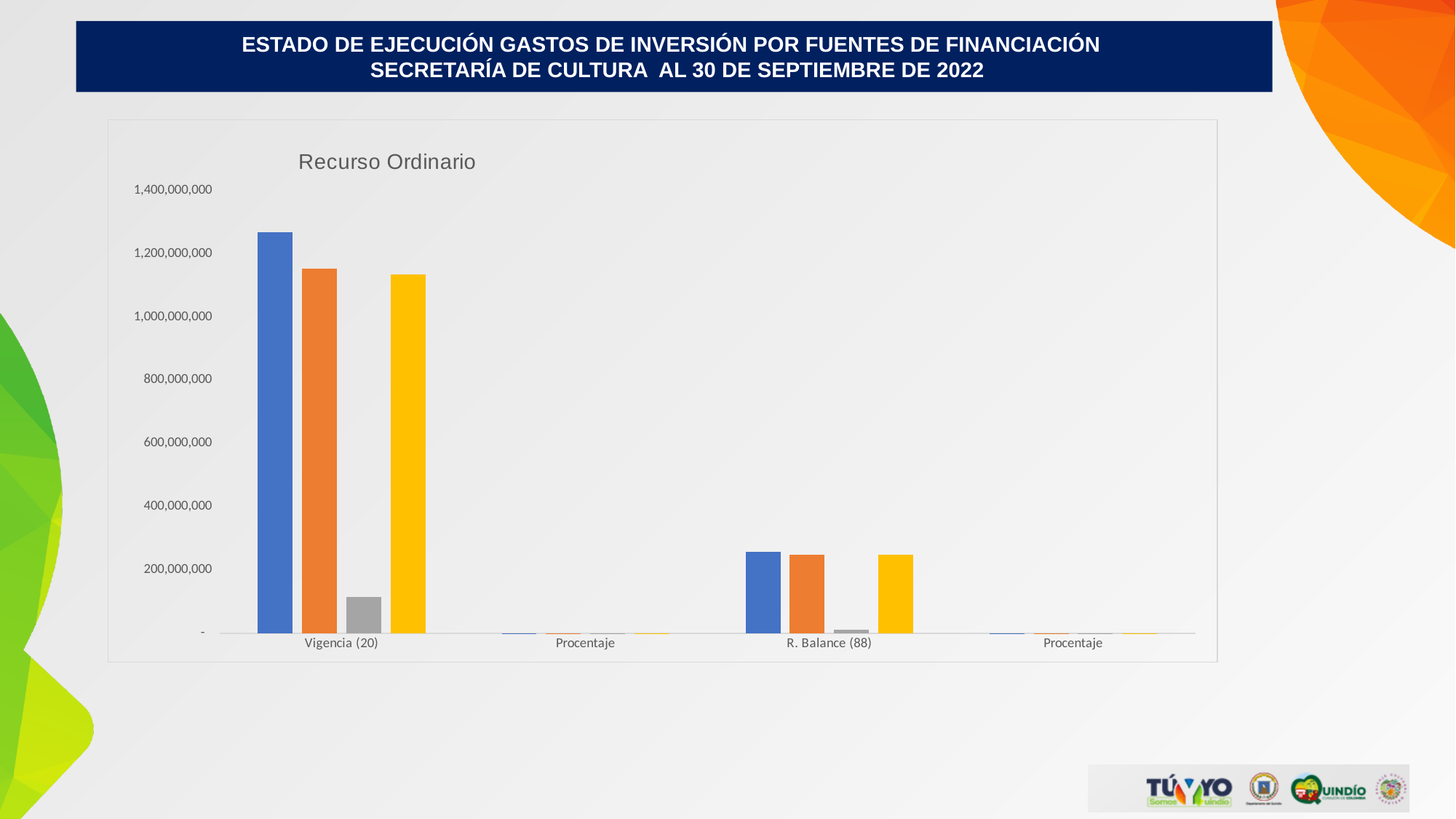
Is the value of the yellow bar for Vigencia (20) greater or less than 1,000,000,000? greater What kind of chart is shown on the slide? bar chart Is the value of the blue bar for Vigencia (20) greater or less than 1,200,000,000? greater Is the value of the orange bar for Vigencia (20) greater or less than 1,200,000,000? less What is the title of the chart? Recurso Ordinario How many bars are plotted for the Vigencia (20) category? 4 Within the Vigencia (20) category, which is larger, the blue bar or the orange bar? the blue bar Which category has the tallest bar in the chart? Vigencia (20) How many categories are shown on the x axis of the chart? 4 Which is larger, the blue bar for Vigencia (20) or the blue bar for R. Balance (88)? Vigencia (20)